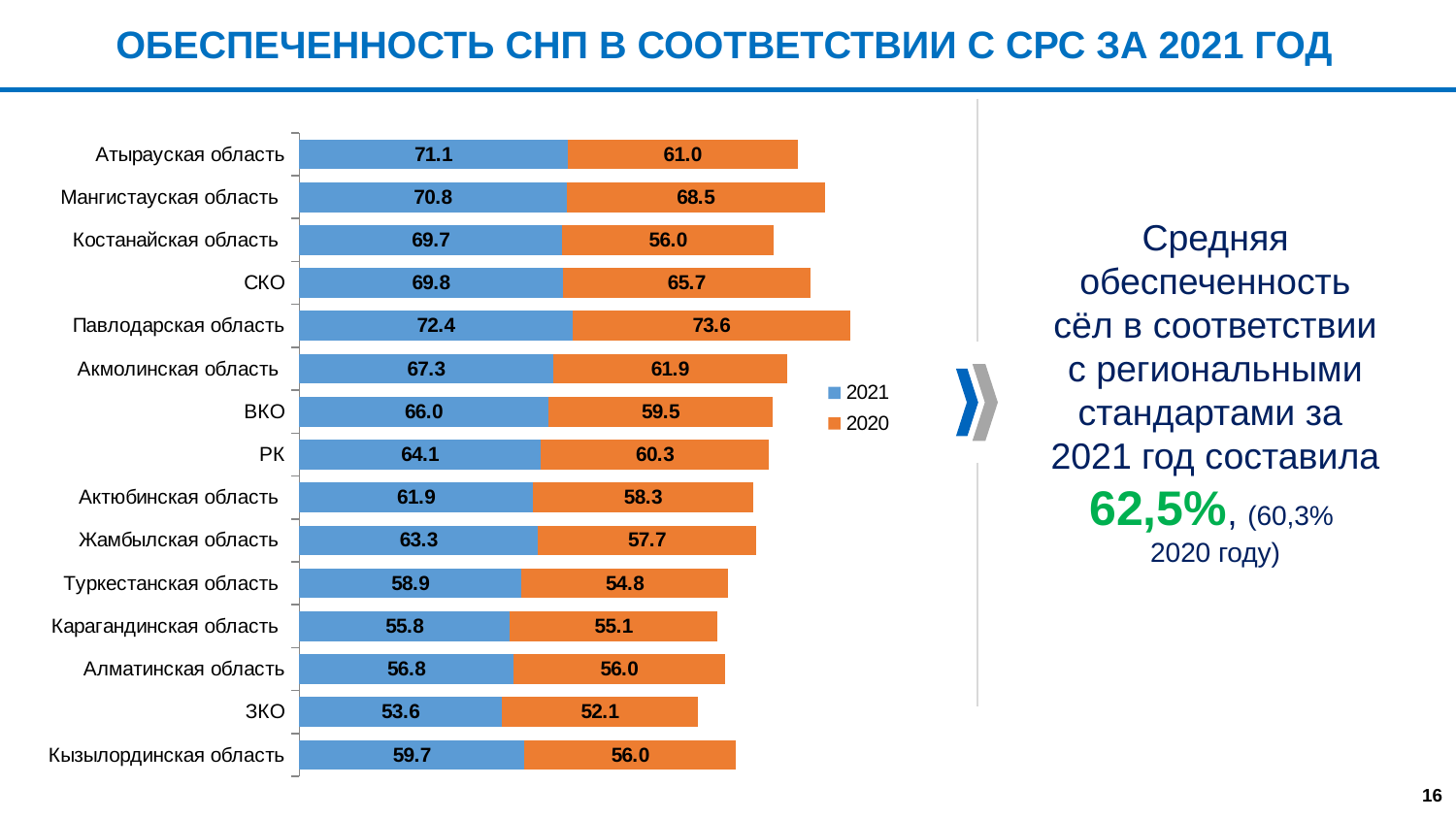
What is the total of the stacked bar for Павлодарская область? 146.0 What is the 2021 value for Атырауская область? 71.1 For Павлодарская область, which is larger: the 2021 value or the 2020 value? 2020 Which colour represents the 2020 series in the legend? Orange What is the 2021 value for РК? 64.1 Which region has the lowest 2020 value? ЗКО Which region has the highest 2021 value? Павлодарская область What is the difference between the 2021 and 2020 values for Костанайская область? 13.7 How many categories (regions) are shown on the chart? 15 How many series does the legend list? 2 What type of chart is shown on the slide? Stacked bar chart What is the 2020 value for Мангистауская область? 68.5